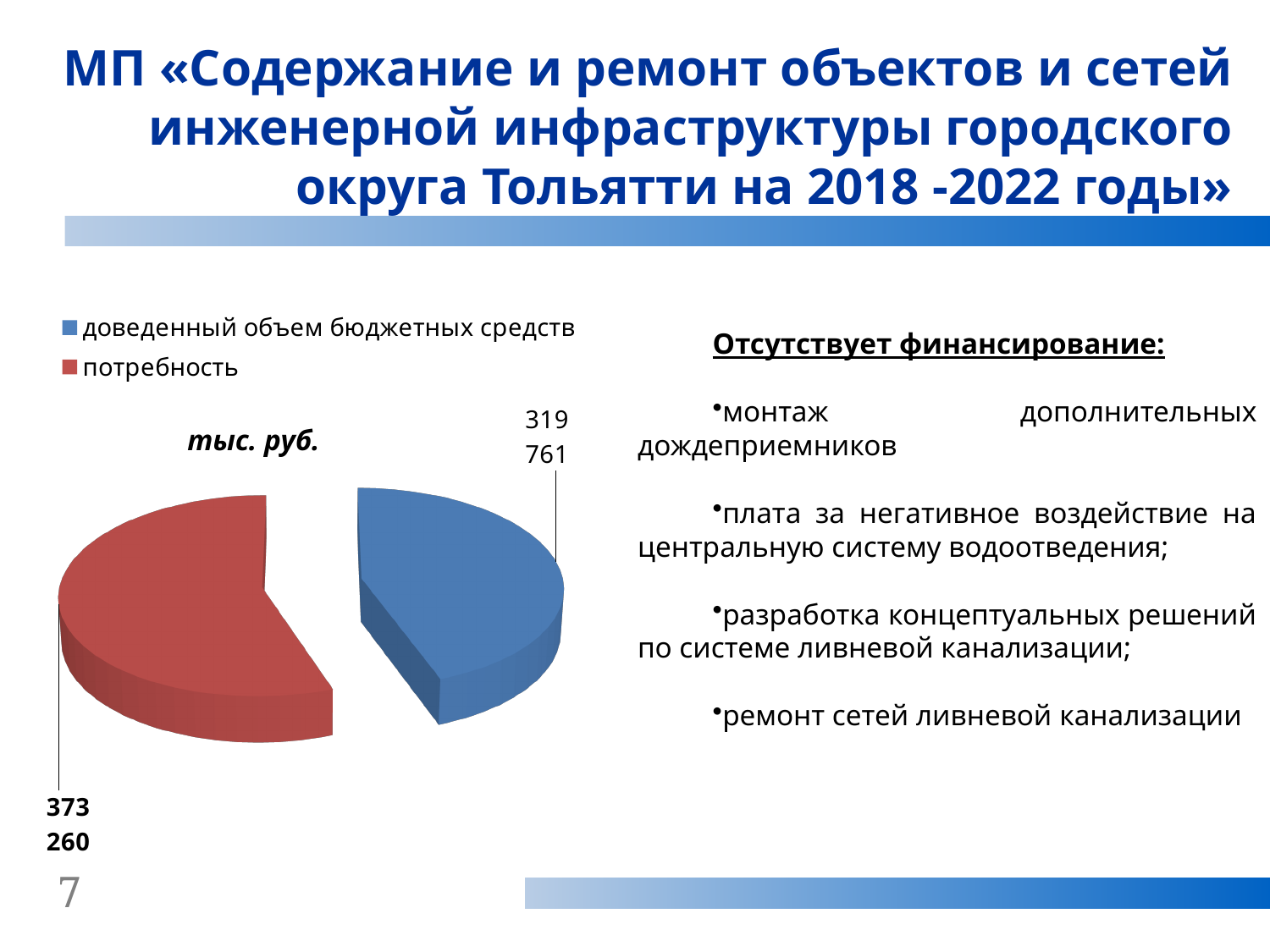
Which slice of the pie chart is the smallest? доведенный объем бюджетных средств What is the value for «потребность» on the pie chart? 373 260 Which slice of the pie chart is the largest? потребность What colour is the «потребность» slice in the pie chart? red Which is larger: «потребность» or «доведенный объем бюджетных средств»? потребность How many slices does the pie chart have? 2 What is the total of the two values shown on the pie chart? 693 021 How many entries does the chart legend list? 2 What is the difference between «потребность» and «доведенный объем бюджетных средств»? 53 499 What kind of chart is shown on the slide? pie chart What is the value for «доведенный объем бюджетных средств» on the pie chart? 319 761 What unit is indicated next to the pie chart? тыс. руб.